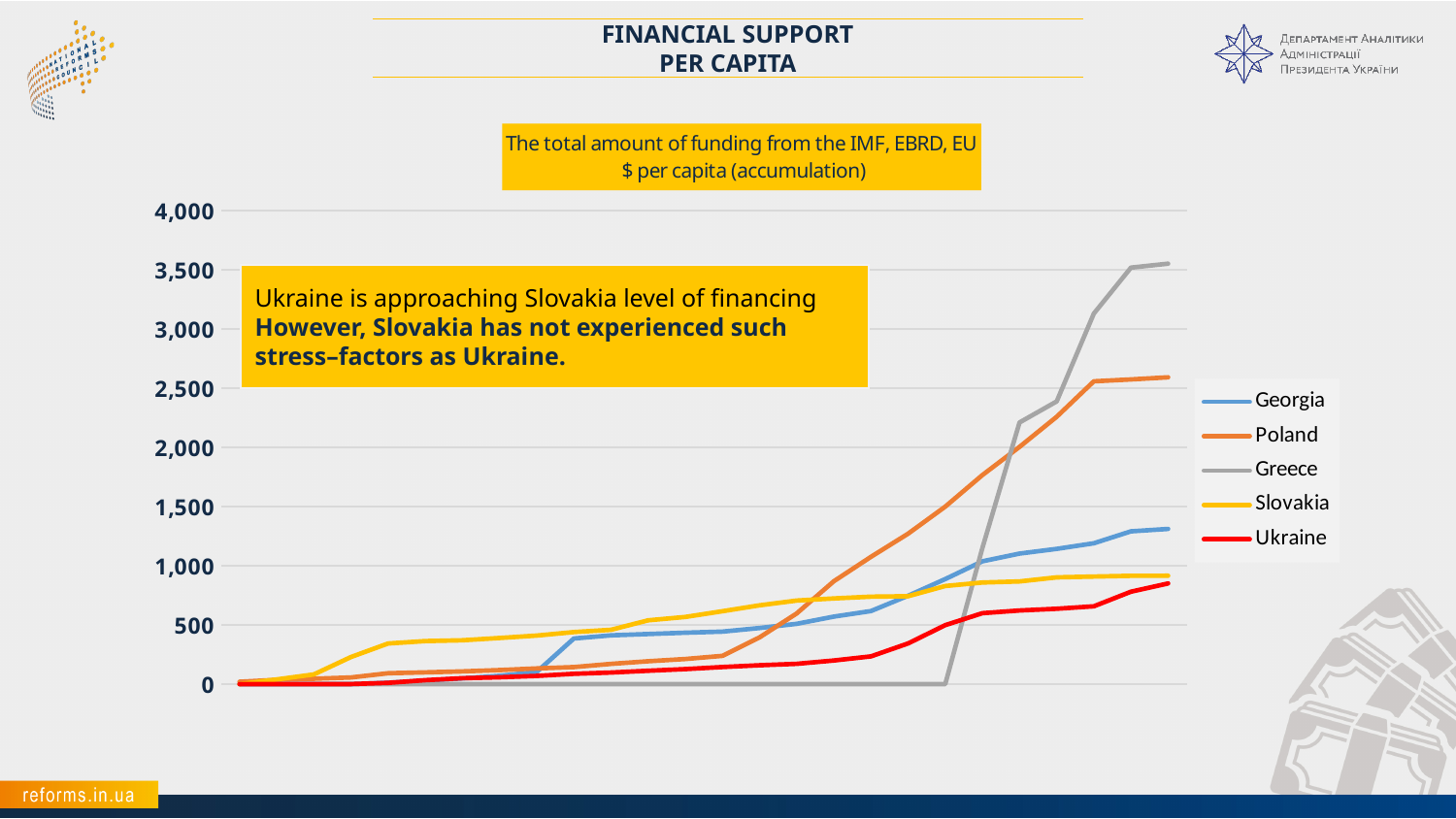
What is the title of the chart? The total amount of funding from the IMF, EBRD, EU $ per capita (accumulation) Is the final value for Georgia greater or less than 1,500? less Which series reaches the highest value at the right end of the chart? Greece Which series has the lowest value at the right end of the chart? Ukraine Do the values for Ukraine generally rise or fall along the x axis? rise Is the final value for Poland greater or less than 2,500? greater Which series is drawn in red? Ukraine Is the final value for Greece greater or less than 3,000? greater How many series does the legend list? 5 At the right end of the chart, which is larger: the value for Poland or the value for Georgia? Poland What kind of chart is shown on the slide? line chart